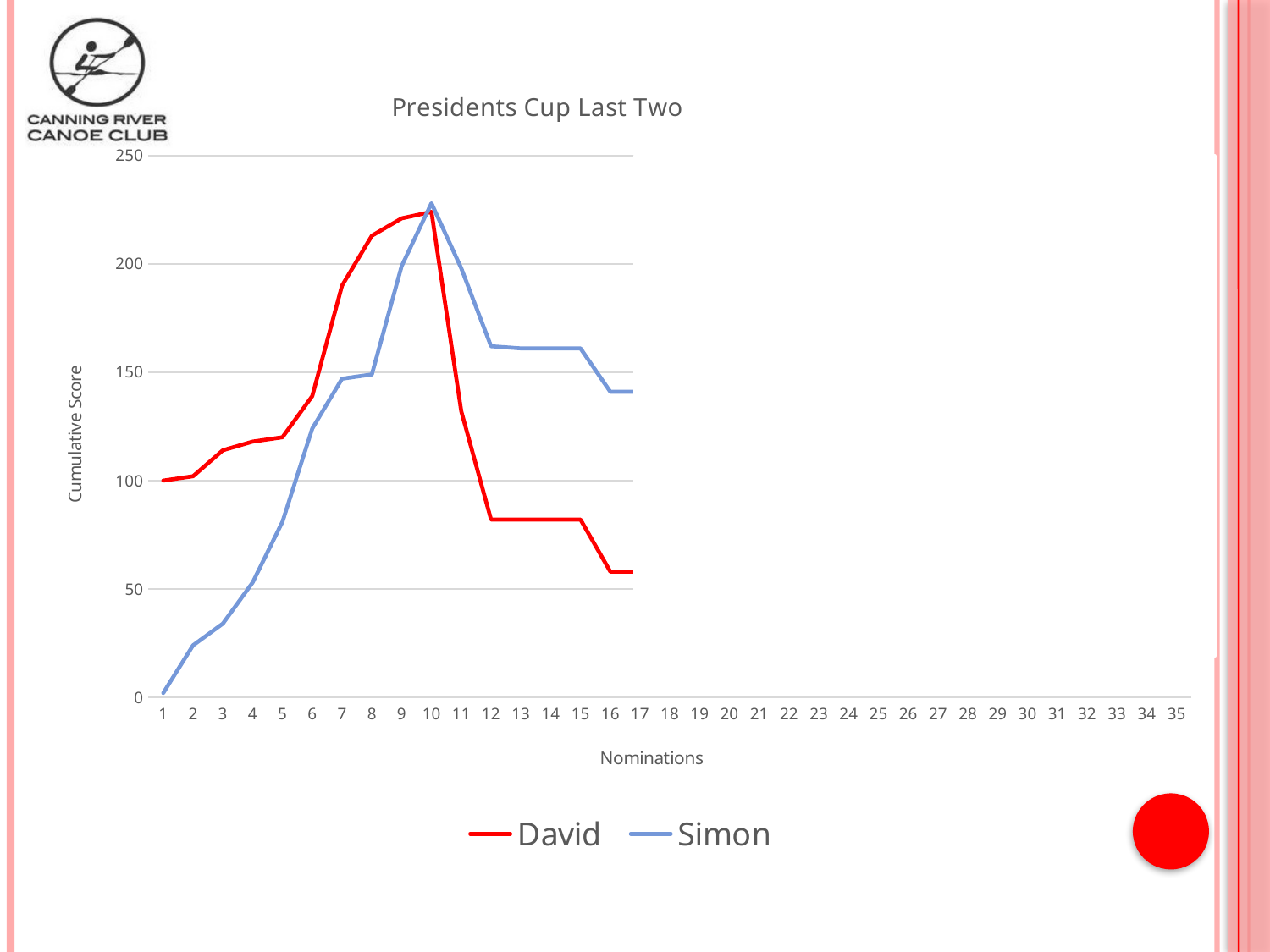
Is Simon's value at nomination 5 greater or less than 100? less What is the title of the chart? Presidents Cup Last Two What kind of chart is shown on the slide? line chart Is Simon's value at nomination 12 greater or less than 150? greater Is David's value at nomination 10 greater or less than 200? greater How many series does the legend list? 2 At nomination 17, which series has the higher value, David or Simon? Simon Does David's line rise or fall between nomination 10 and nomination 17? fall At nomination 3, which series has the higher value, David or Simon? David What is the label on the vertical axis? Cumulative Score